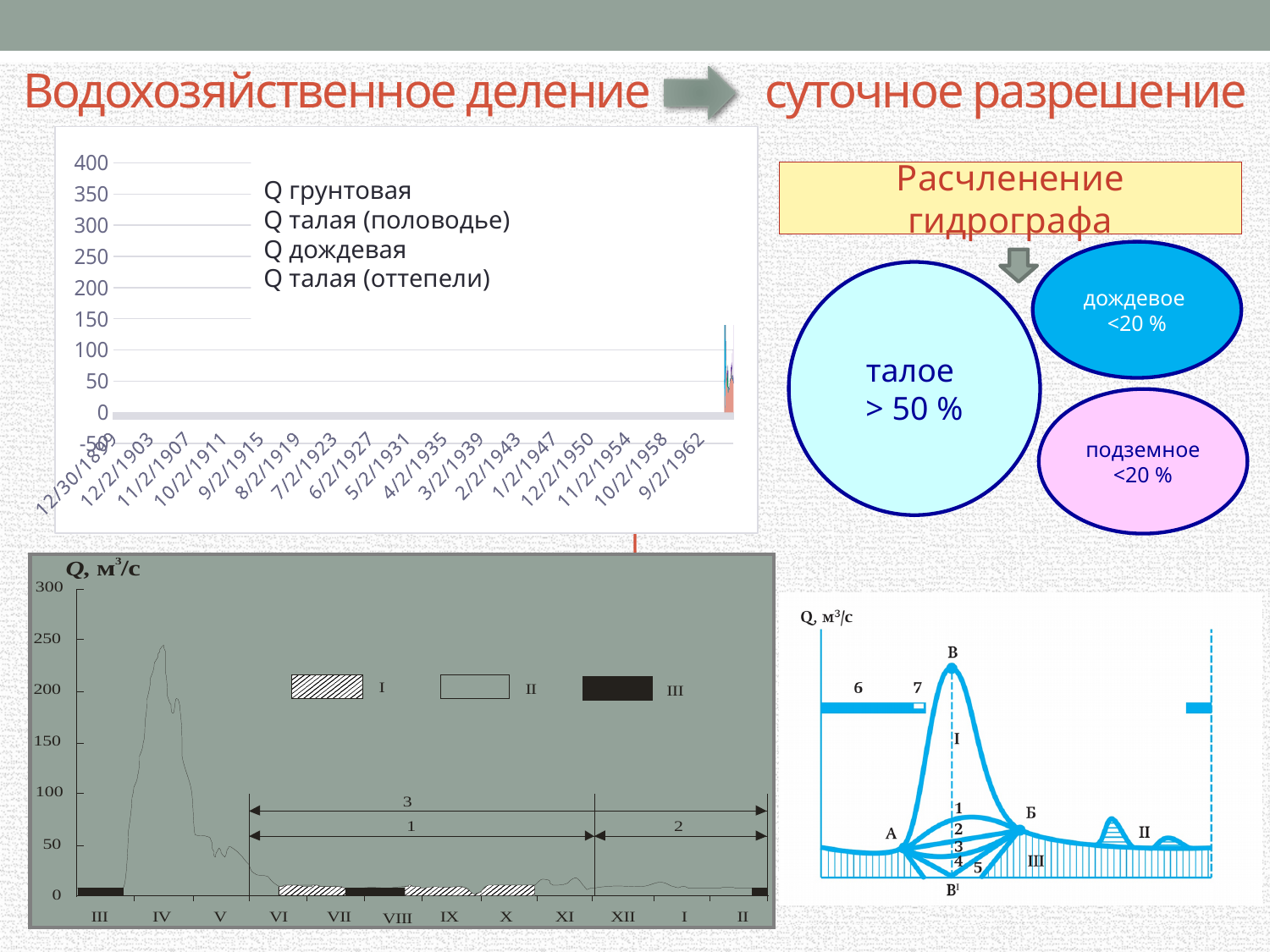
In the bottom-left hydrograph, how many legend entries are shown? 3 In the bottom-left hydrograph, is the discharge higher in month IV or month X? IV In the top-left chart, what is the last date label on the horizontal axis? 9/2/1962 In the top-left chart, what is the lowest value shown on the vertical axis? -50 In the bottom-left hydrograph, what is the maximum value on the vertical axis? 300 In the bottom-left hydrograph, is the peak discharge in month IV greater or less than 200? greater In the top-left chart, how many series does the legend list? 4 In the bottom-left hydrograph, is the discharge in month VII greater or less than 50? less In the bottom-left hydrograph, which month has the highest discharge? IV In the bottom-left hydrograph, how many month labels are on the horizontal axis? 12 In the top-left chart, what is the first legend entry? Q грунтовая In the top-left chart, what is the highest value shown on the vertical axis? 400